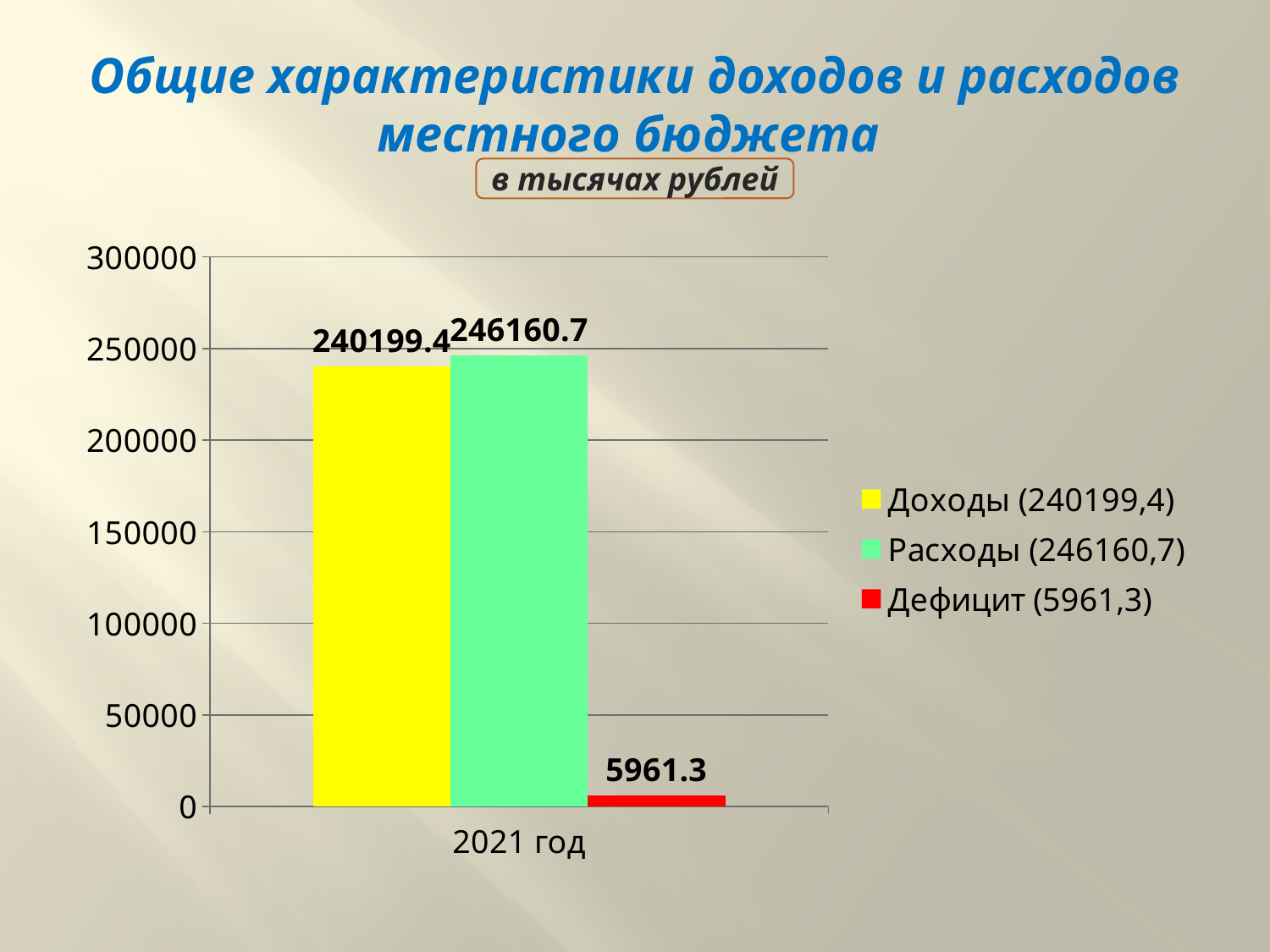
What colour is the Дефицит bar? red Which series has the highest value in the chart? Расходы What is the value of the Доходы bar for 2021 год? 240199.4 What is the difference between the Расходы value and the Доходы value? 5961.3 Is the value for Доходы greater or less than 200000? greater What kind of chart is shown on the slide? bar chart What is the value of the Расходы bar for 2021 год? 246160.7 Which is larger, the Доходы value or the Расходы value? Расходы How many series does the legend list? 3 Which series has the lowest value in the chart? Дефицит What is the value of the Дефицит bar for 2021 год? 5961.3 How many categories are shown on the x axis? 1